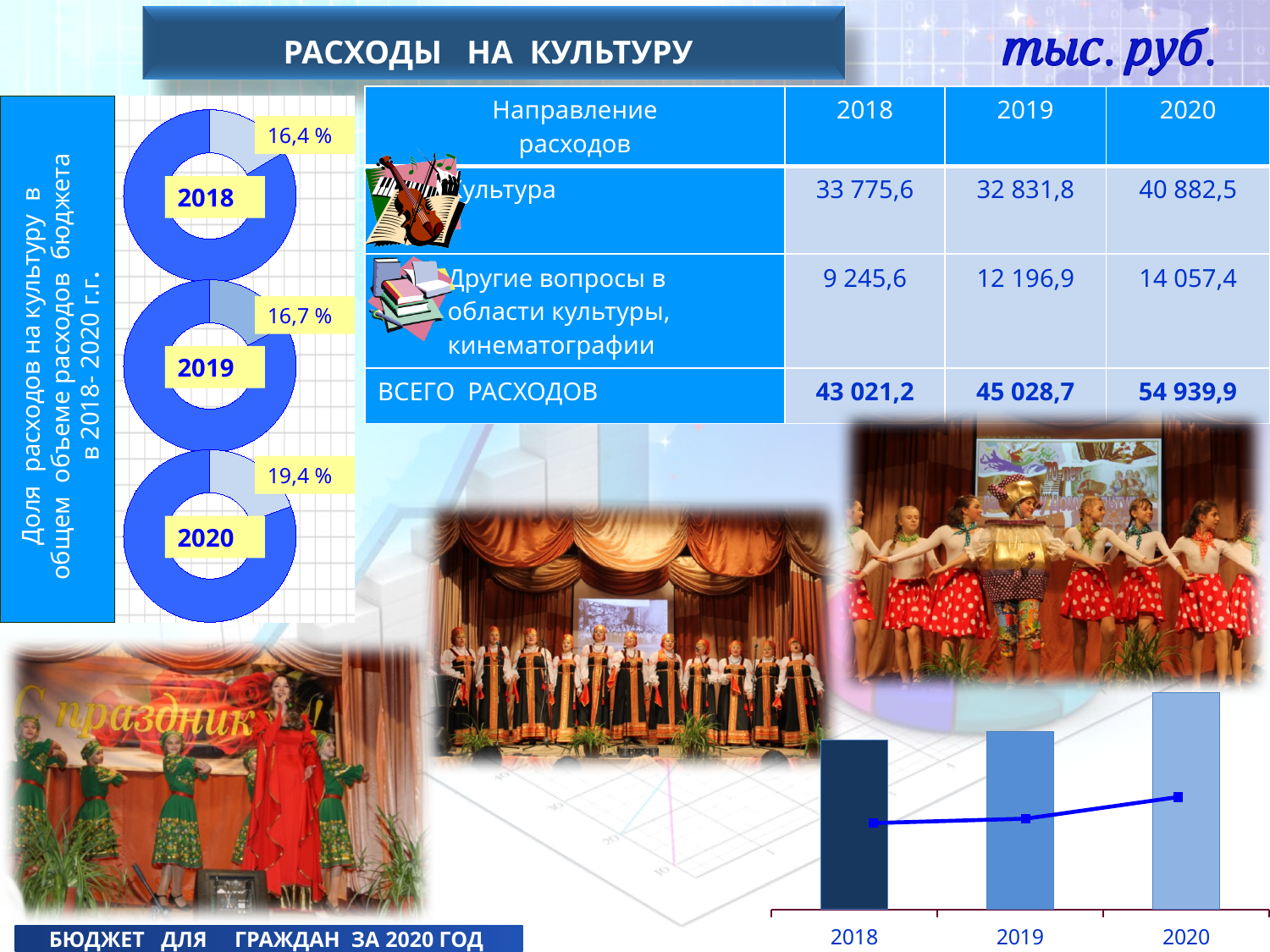
In the donut charts on the left, what share is shown for 2020? 19,4 % In the bar chart in the bottom right corner, which year has the tallest bar? 2020 Among the donut charts on the left, which year has the lowest share of culture expenses? 2018 How many donut charts are shown on the left side of the slide? 3 Do the shares in the donut charts on the left rise or fall from 2018 to 2020? rise In the donut charts on the left, by how many percentage points is the 2020 share higher than the 2018 share? 3,0 % In the donut charts on the left, which is larger: the share for 2019 or the share for 2020? 2020 How many bars are shown in the bar chart in the bottom right corner? 3 What kind of chart is shown in the bottom right corner of the slide? bar chart In the donut charts on the left, what share of total budget expenses did culture account for in 2018? 16,4 % Among the donut charts on the left, which year has the highest share of culture expenses? 2020 In the donut charts on the left, what share is shown for 2019? 16,7 %